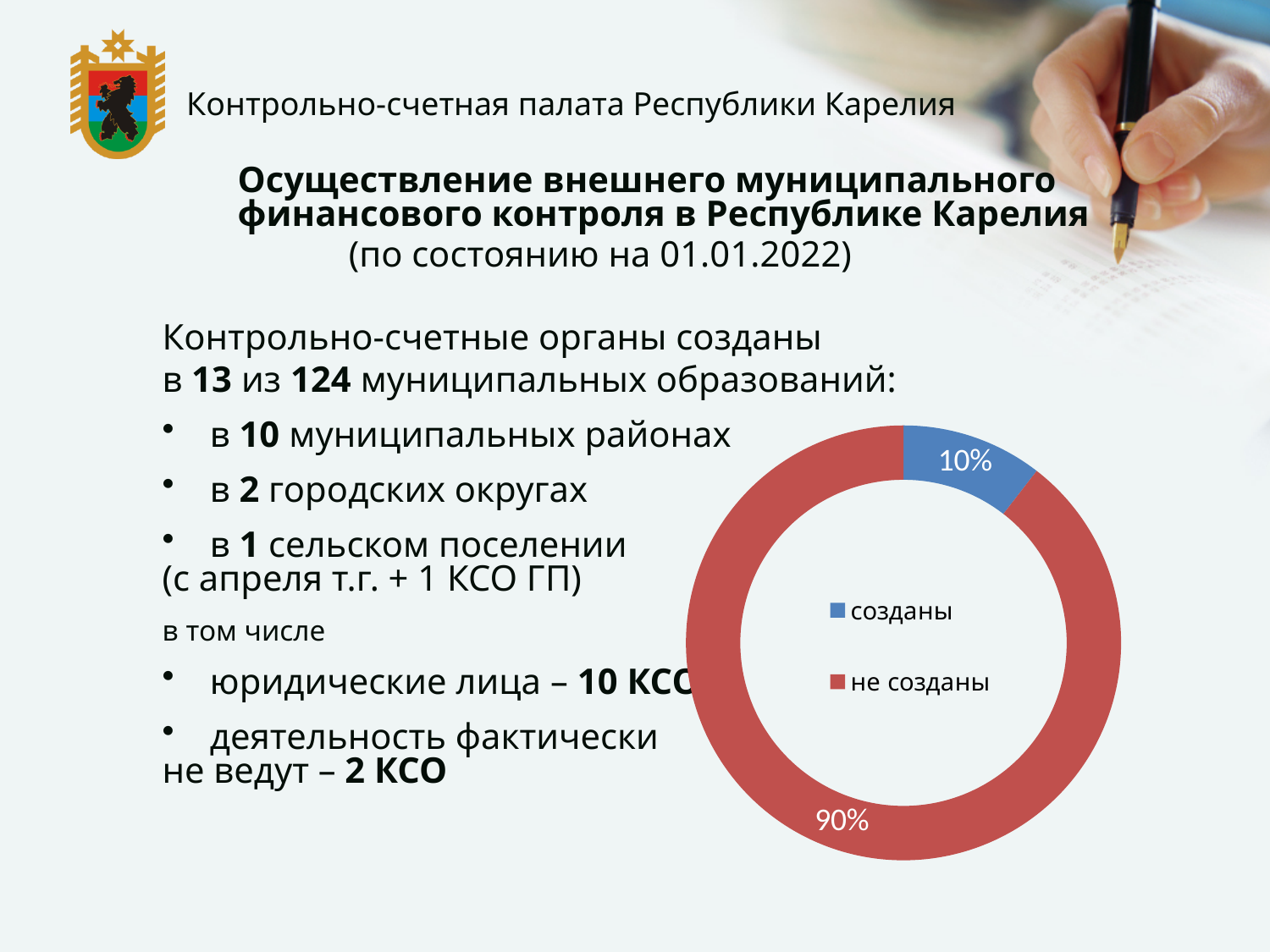
How many entries does the chart legend list? 2 How many slices does the doughnut chart have? 2 Which is larger in the doughnut chart: "созданы" or "не созданы"? не созданы What share of the doughnut chart does the "не созданы" slice represent? 90% Which slice of the doughnut chart is the largest? не созданы Which slice of the doughnut chart is the smallest? созданы What share of the doughnut chart does the "созданы" slice represent? 10% What colour is the "не созданы" slice in the doughnut chart? Red What is the difference in percentage points between the "не созданы" and "созданы" slices? 80 percentage points Is the share of the "созданы" slice greater or less than 50%? less What kind of chart is shown on the slide? Doughnut (pie) chart What colour is the "созданы" slice in the doughnut chart? Blue